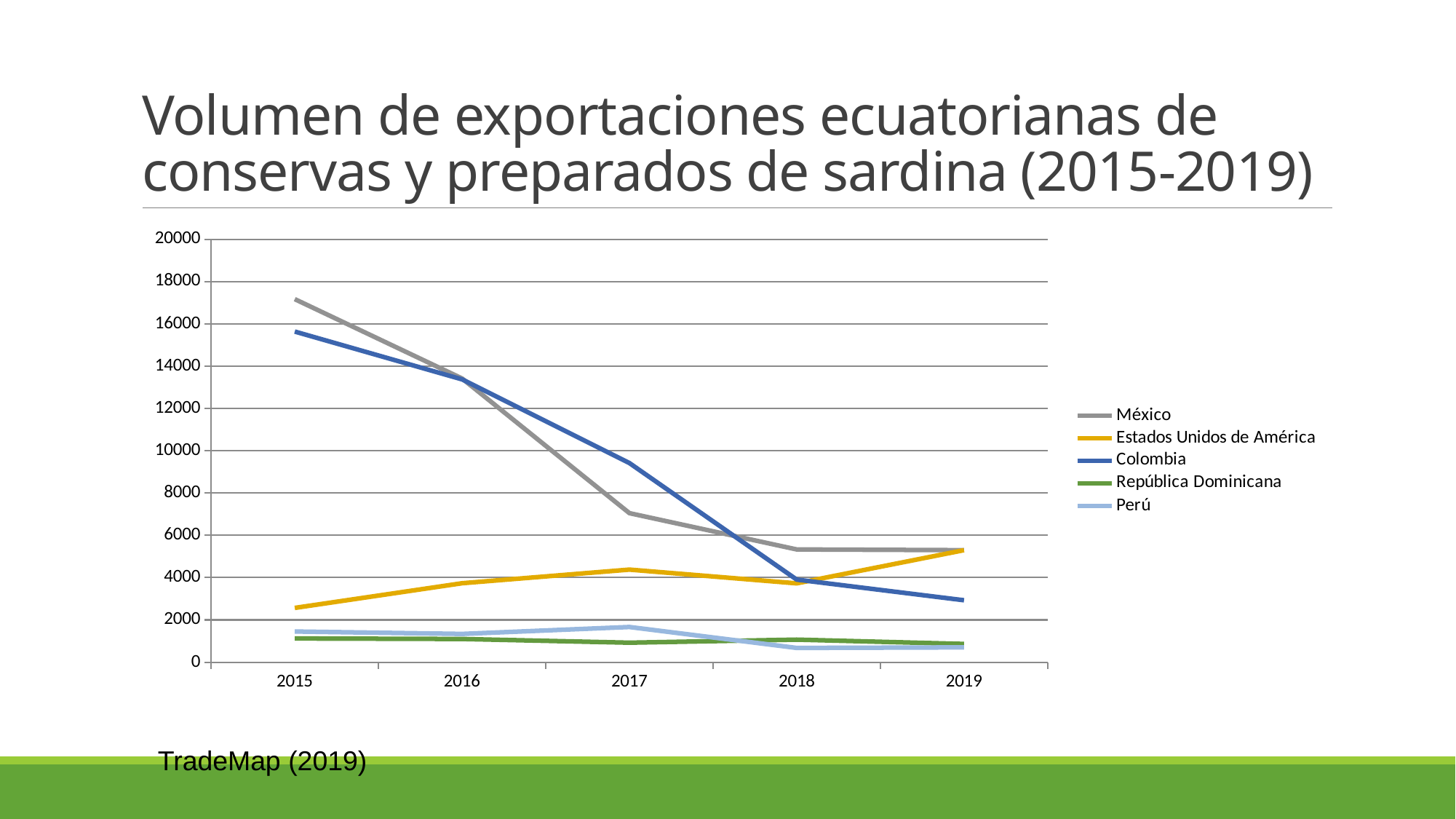
Is the value for Colombia in 2019 greater or less than 4000? less Which country had the lowest export volume in 2015? República Dominicana How many years are shown on the x axis? 5 Which country had the lowest export volume in 2018? Perú Which country had the highest export volume in 2015? México Does the export volume for México rise or fall from 2015 to 2019? fall Is the value for Estados Unidos de América in 2017 greater or less than 4000? greater Is the value for México in 2015 greater or less than 16000? greater In 2019, which is larger: the value for Colombia or the value for Estados Unidos de América? Estados Unidos de América In 2017, which is larger: the value for Colombia or the value for México? Colombia How many series does the legend list? 5 What kind of chart is shown on the slide? line chart